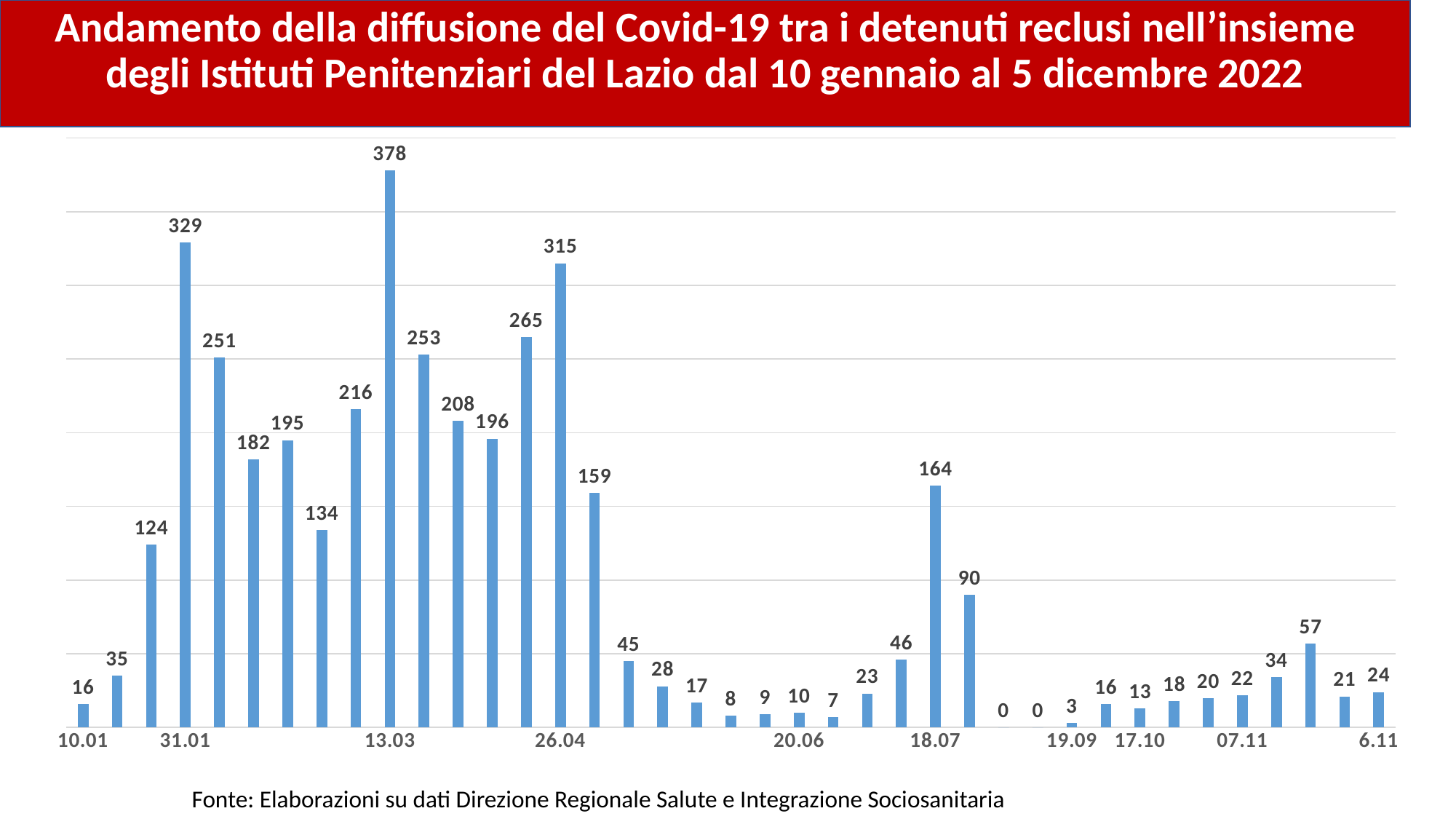
What is the value for 10.01? 16 How many bars are plotted on the chart? 39 Which labelled date has the highest value? 13.03 What is the difference between the values for 13.03 and 31.01? 49 What is the lowest value shown on the chart? 0 What is the value for 31.01? 329 What is the value for 18.07? 164 Which is larger, the value for 31.01 or the value for 26.04? 31.01 What is the value for 13.03? 378 What is the value for 26.04? 315 What kind of chart is shown on the slide? Bar chart What is the value for 07.11? 22